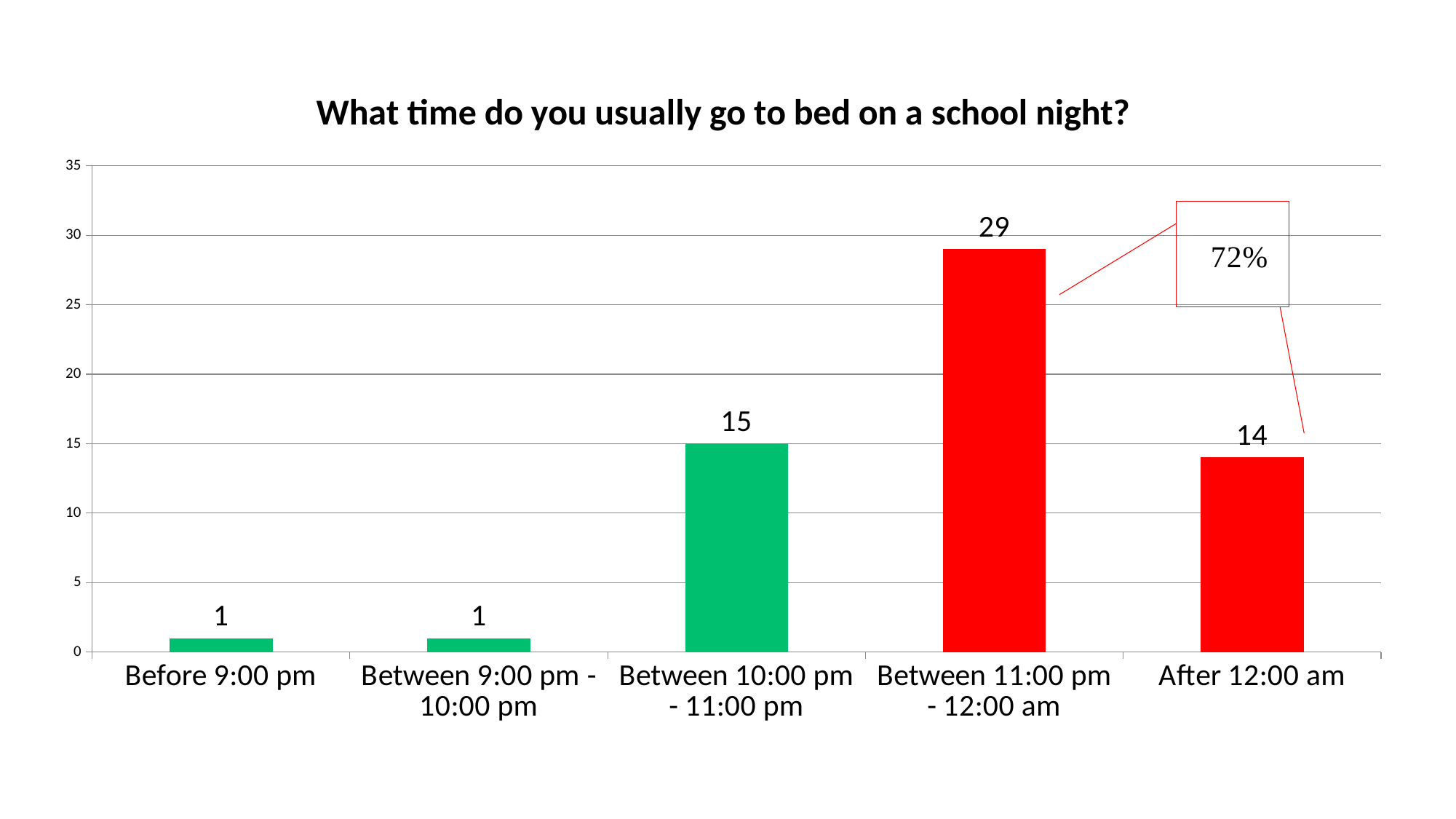
Which is larger, the value for 'Between 10:00 pm - 11:00 pm' or the value for 'After 12:00 am'? Between 10:00 pm - 11:00 pm What is the title of the chart? What time do you usually go to bed on a school night? What is the value for 'After 12:00 am'? 14 How many categories are shown on the x axis? 5 What is the difference between the values for 'Between 11:00 pm - 12:00 am' and 'After 12:00 am'? 15 Is the value for 'Between 11:00 pm - 12:00 am' greater or less than 25? greater What is the difference between the values for 'Between 10:00 pm - 11:00 pm' and 'Between 9:00 pm - 10:00 pm'? 14 Which category has the highest value? Between 11:00 pm - 12:00 am What kind of chart is shown on the slide? bar chart What is the value for 'Between 11:00 pm - 12:00 am'? 29 What is the value for 'Before 9:00 pm'? 1 What is the value for 'Between 10:00 pm - 11:00 pm'? 15